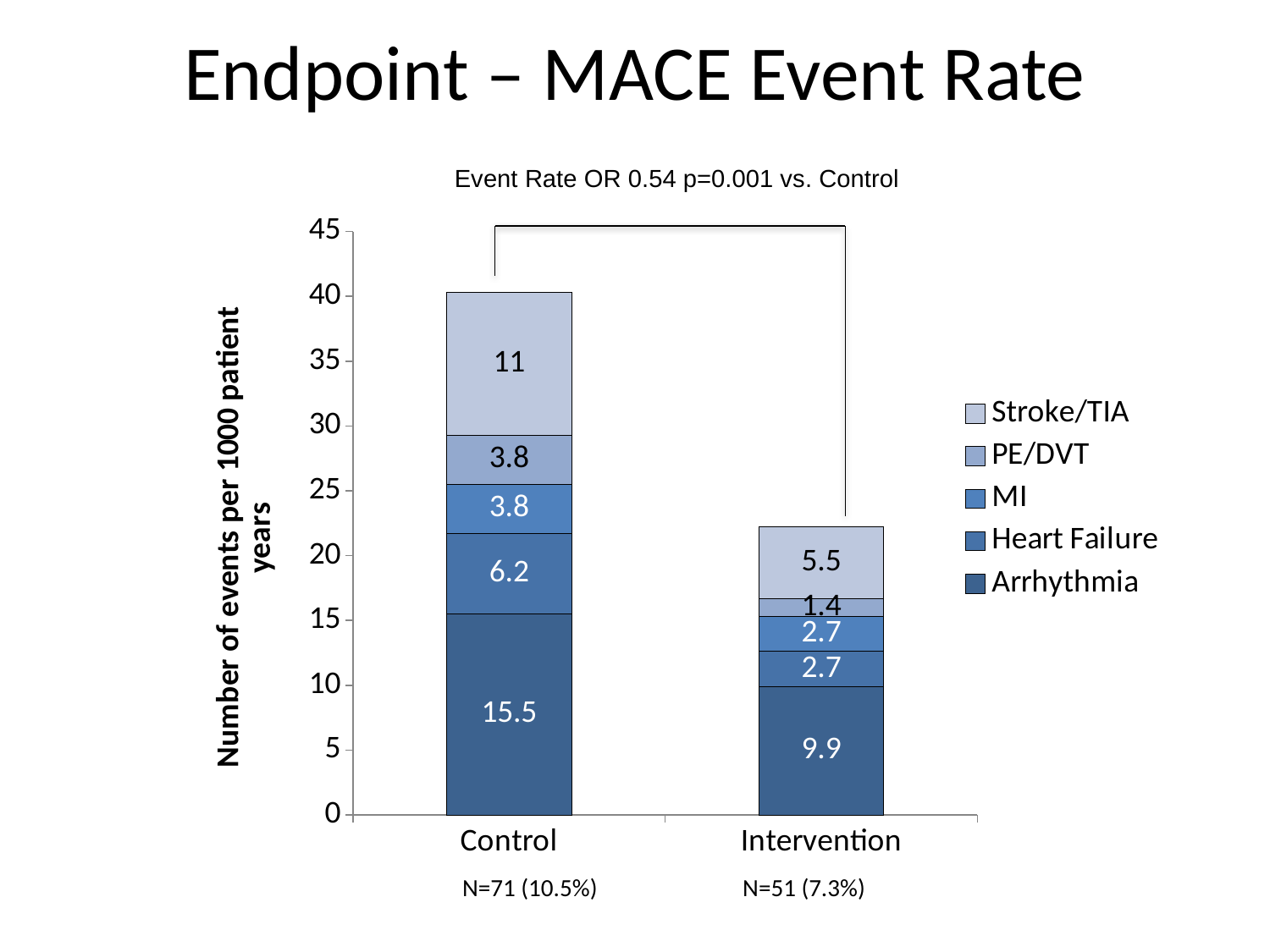
What is the label of the y axis? Number of events per 1000 patient years What type of chart is shown on the slide? Stacked bar chart Which group has the larger Stroke/TIA value, Control or Intervention? Control What is the total of the stacked bar for the Control group? 40.3 What is the total of the stacked bar for the Intervention group? 22.2 How many series does the legend list? 5 What is the difference between the Arrhythmia values for Control and Intervention? 5.6 How many categories are shown on the x axis? 2 What is the Stroke/TIA value for the Intervention group? 5.5 What is the PE/DVT value for the Intervention group? 1.4 What is the Heart Failure value for the Control group? 6.2 What is the Arrhythmia value for the Control group? 15.5